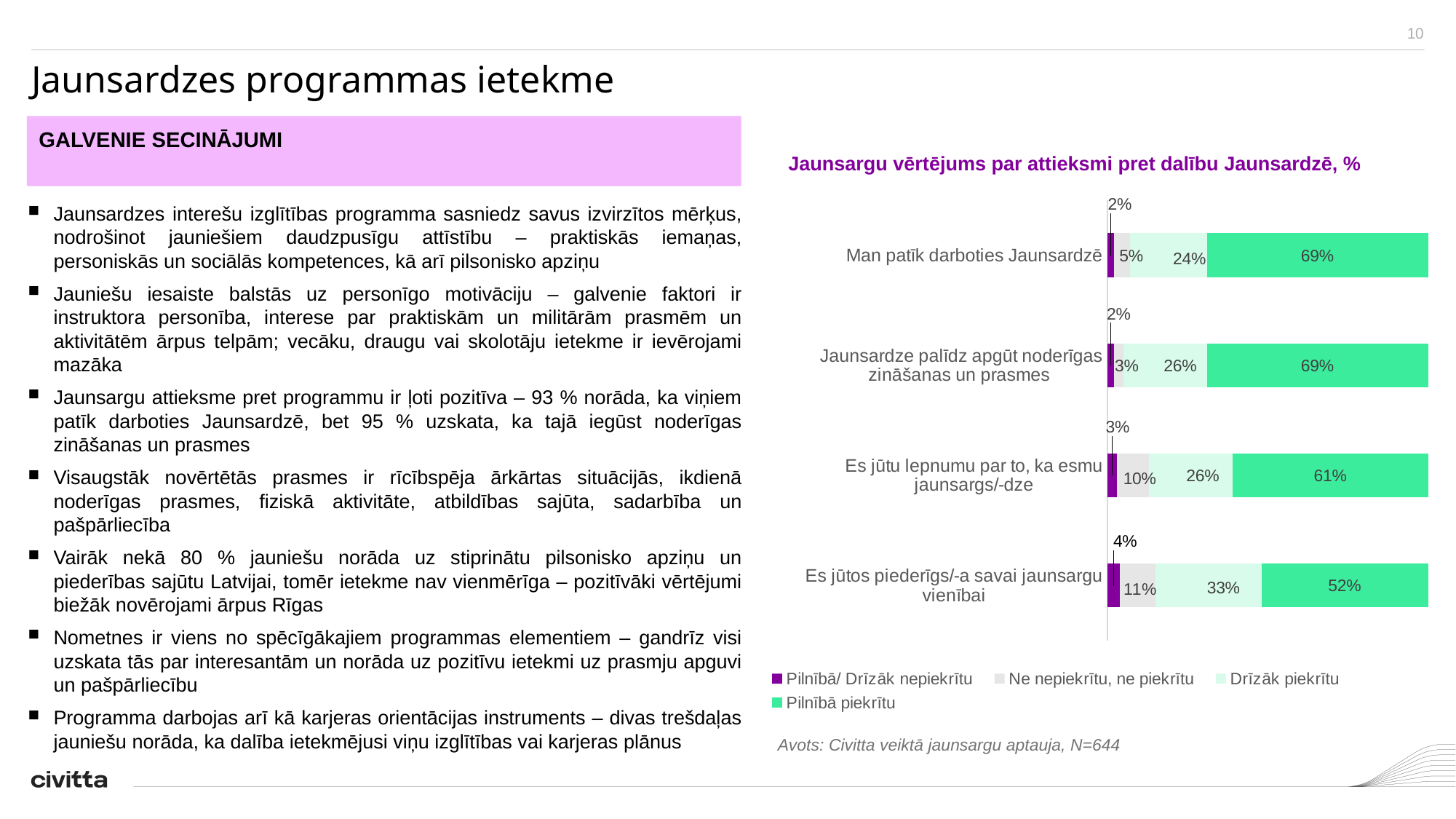
What is the title of the chart? Jaunsargu vērtējums par attieksmi pret dalību Jaunsardzē, % How many statements (categories) are plotted in the chart? 4 How many series does the chart legend list? 4 What is the 'Ne nepiekrītu, ne piekrītu' value for 'Es jūtu lepnumu par to, ka esmu jaunsargs/-dze'? 10% What is the 'Drīzāk piekrītu' value for 'Es jūtos piederīgs/-a savai jaunsargu vienībai'? 33% What is the difference between the 'Pilnībā piekrītu' values for 'Man patīk darboties Jaunsardzē' and 'Es jūtos piederīgs/-a savai jaunsargu vienībai'? 17% Which is larger: the 'Drīzāk piekrītu' value for 'Es jūtu lepnumu par to, ka esmu jaunsargs/-dze' or for 'Man patīk darboties Jaunsardzē'? Es jūtu lepnumu par to, ka esmu jaunsargs/-dze Which statement has the lowest 'Pilnībā piekrītu' share? Es jūtos piederīgs/-a savai jaunsargu vienībai What type of chart is shown on the slide? Stacked bar chart What is the 'Pilnībā piekrītu' value for 'Man patīk darboties Jaunsardzē'? 69% Which statement has the highest 'Ne nepiekrītu, ne piekrītu' share? Es jūtos piederīgs/-a savai jaunsargu vienībai What is the 'Pilnībā/ Drīzāk nepiekrītu' value for 'Jaunsardze palīdz apgūt noderīgas zināšanas un prasmes'? 2%